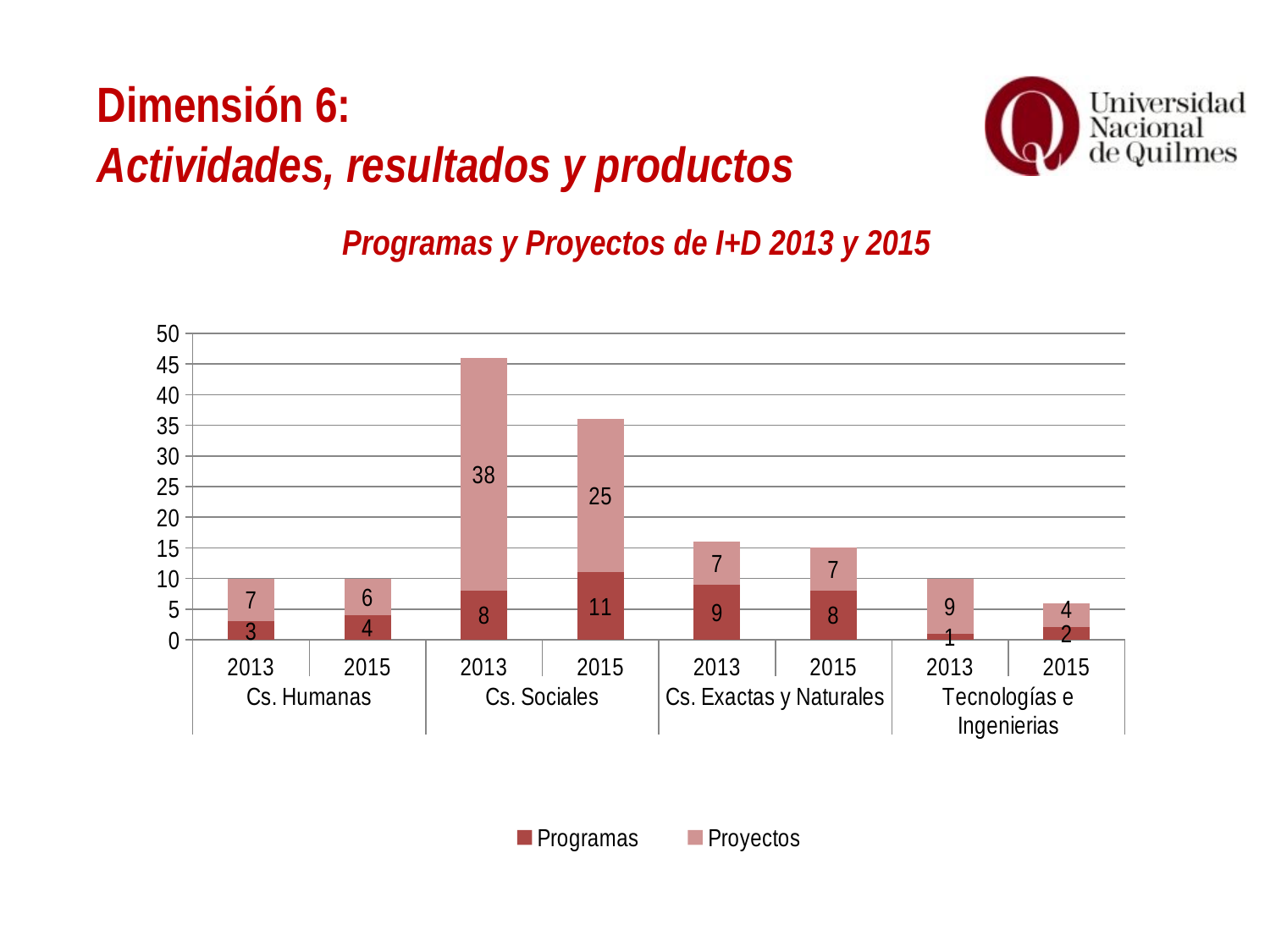
What is the value of Programas for Cs. Exactas y Naturales in 2015? 8 What is the total of the stacked bar for Cs. Sociales in 2015? 36 What is the difference between the Proyectos values for Cs. Sociales in 2013 and 2015? 13 What is the value of Programas for Tecnologías e Ingenierias in 2013? 1 Which category and year has the highest Proyectos value? Cs. Sociales, 2013 How many series does the legend list? 2 What is the total of the stacked bar for Cs. Humanas in 2013? 10 Which category and year has the lowest Programas value? Tecnologías e Ingenierias, 2013 What is the value of Proyectos for Cs. Sociales in 2013? 38 What is the title of the chart? Programas y Proyectos de I+D 2013 y 2015 What kind of chart is shown on the slide? Stacked bar chart Which is larger: Programas for Cs. Sociales in 2015 or Programas for Cs. Exactas y Naturales in 2013? Cs. Sociales in 2015